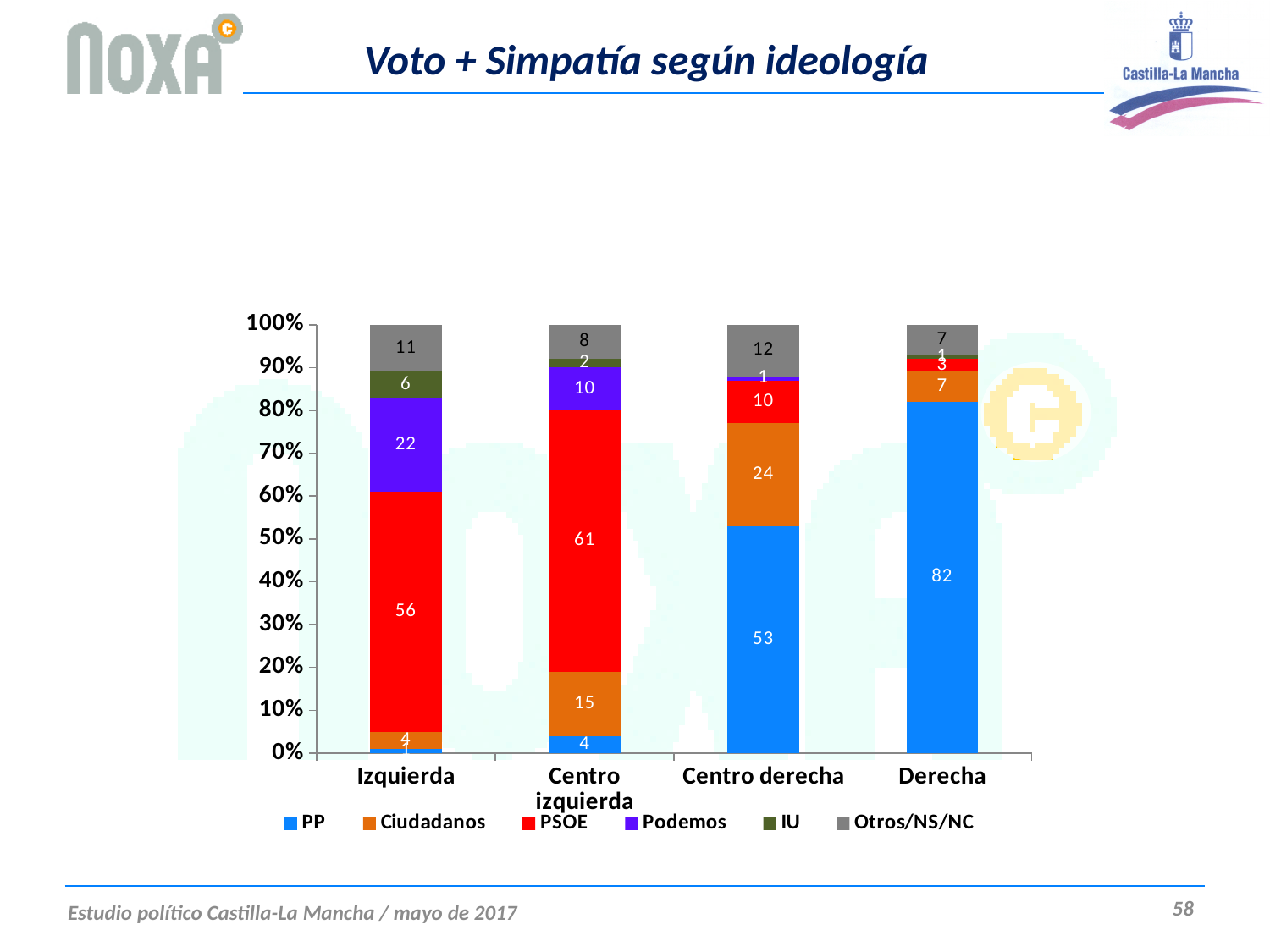
Does the PP value rise or fall moving from Izquierda to Derecha along the x axis? Rise How many series does the legend list? 6 What is the value for Otros/NS/NC in the Centro derecha bar? 12 What kind of chart is shown on the slide? Stacked bar chart What is the value for PP in the Derecha bar? 82 What is the value for Podemos in the Izquierda bar? 22 How many ideology categories are shown on the x axis? 4 Which ideology category has the highest value for PP? Derecha Which is larger, the PSOE value for Izquierda or for Centro izquierda? Centro izquierda What is the difference between the PP value for Derecha and the PP value for Centro derecha? 29 What is the value for Ciudadanos in the Centro derecha bar? 24 What is the value for PSOE in the Izquierda bar? 56